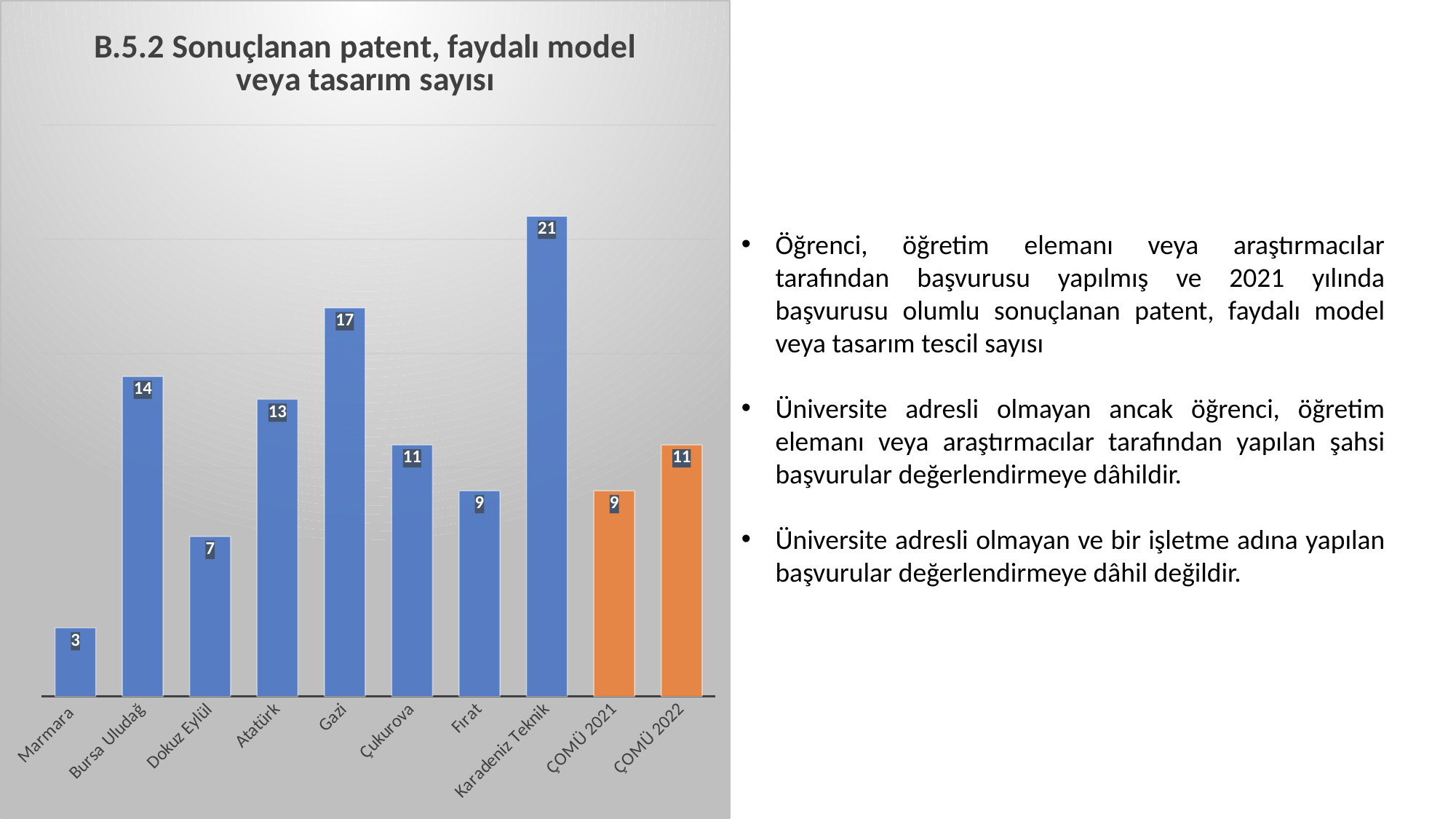
What is the title of the chart? B.5.2 Sonuçlanan patent, faydalı model veya tasarım sayısı How many categories are shown on the x axis? 10 What is the value for Gazi? 17 What is the difference between the values for Karadeniz Teknik and Gazi? 4 Which is larger, the value for Bursa Uludağ or the value for Atatürk? Bursa Uludağ What is the value for Karadeniz Teknik? 21 What is the difference between the values for ÇOMÜ 2022 and ÇOMÜ 2021? 2 Which category has the highest value? Karadeniz Teknik Which category has the lowest value? Marmara What is the value for ÇOMÜ 2022? 11 What is the value for Marmara? 3 What kind of chart is shown on the slide? Bar chart